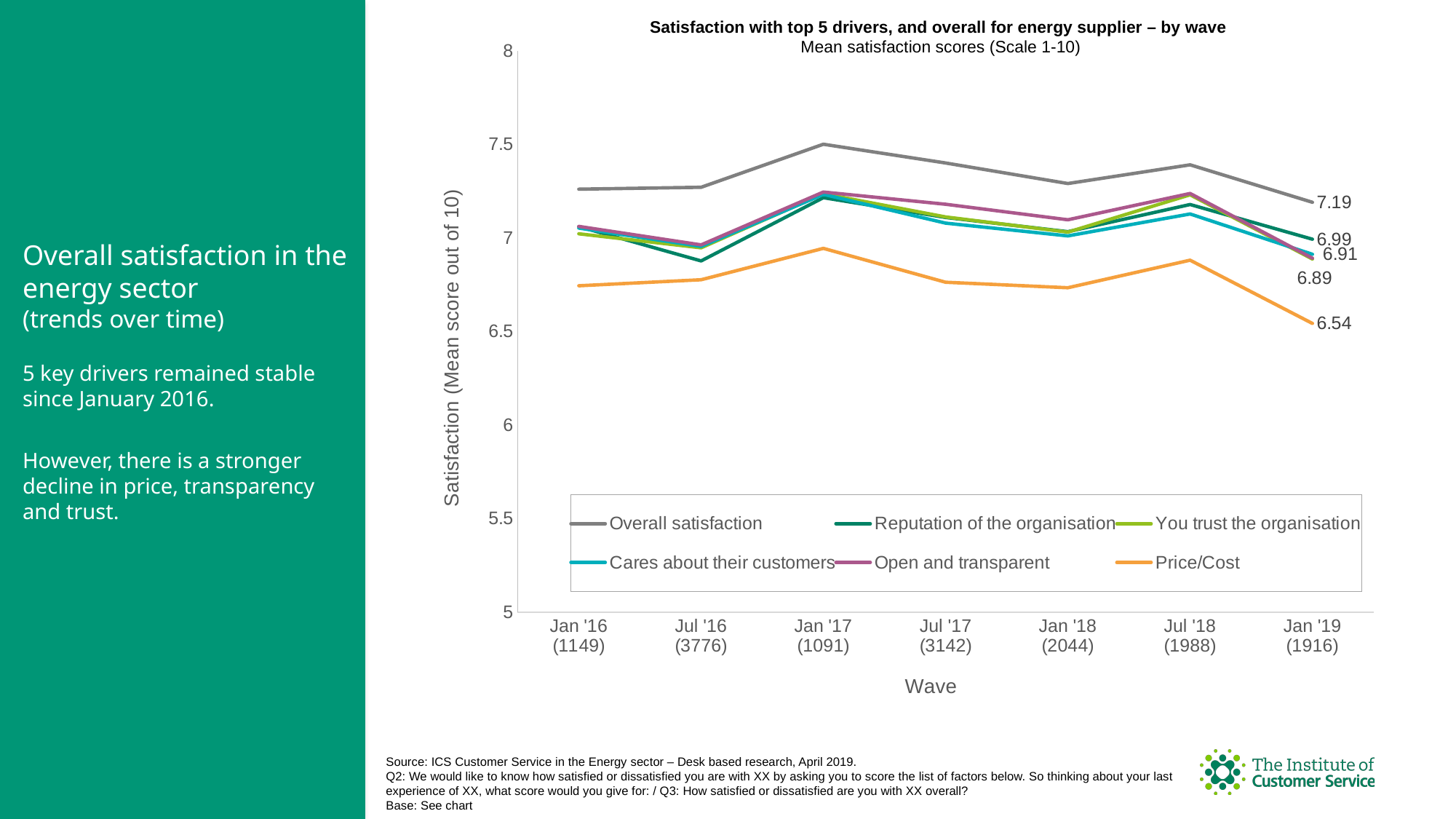
What is the Overall satisfaction score for Jan '19? 7.19 What is the Reputation of the organisation score for Jan '19? 6.99 What is the difference between the Overall satisfaction score and the Price/Cost score in Jan '19? 0.65 Which series has the lowest values across all waves? Price/Cost Is the Price/Cost value for Jan '16 greater or less than 7? less How many waves are plotted along the x axis? 7 How many series does the legend list? 6 In which wave does Overall satisfaction reach its highest value? Jan '17 Is the Overall satisfaction value for Jan '17 greater or less than 7? greater Does the Price/Cost line rise or fall between Jul '18 and Jan '19? Fall What is the Price/Cost score for Jan '19? 6.54 What type of chart is shown on the slide? Line chart